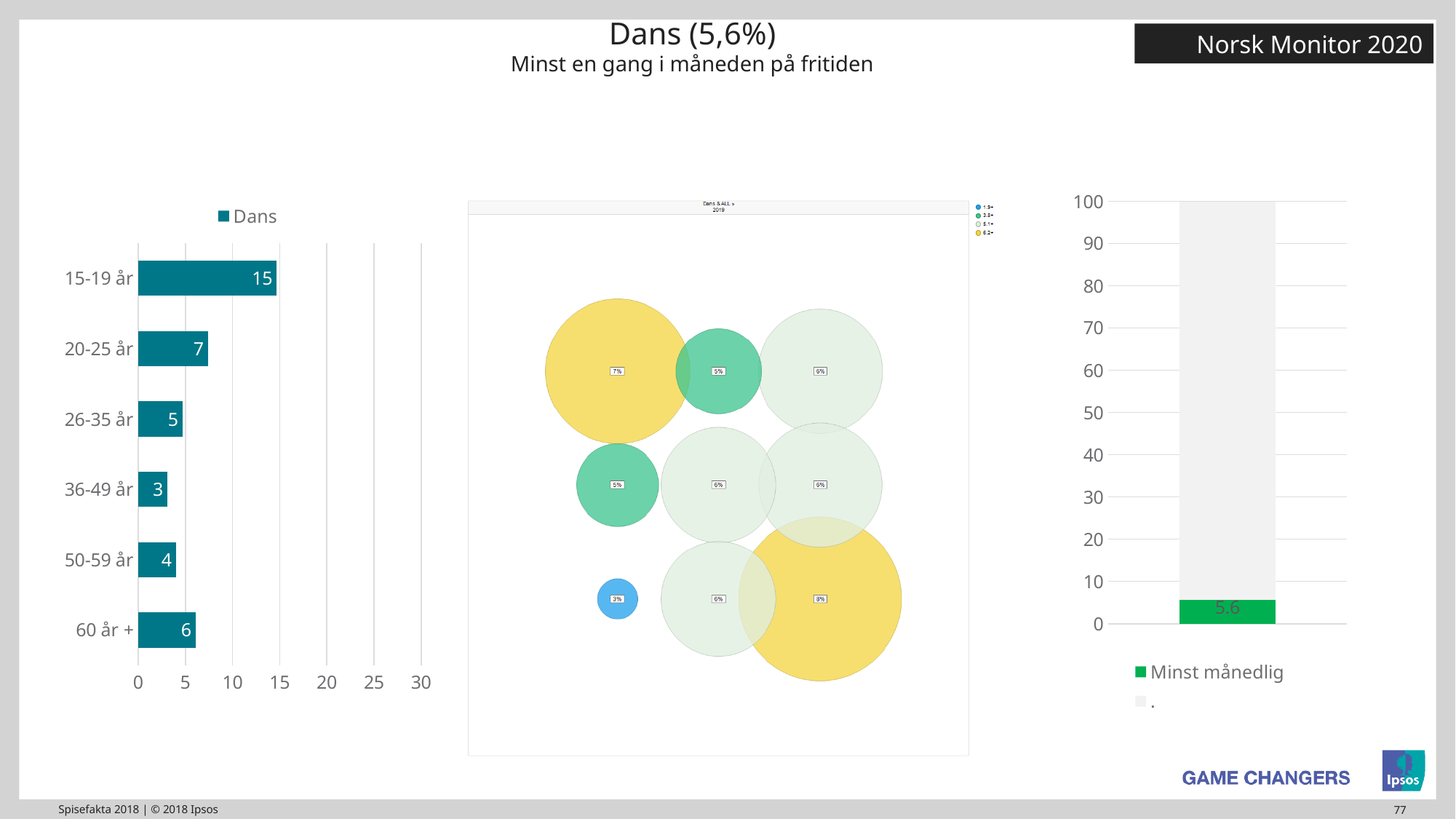
In the left bar chart, what is the difference between the values for 15-19 år and 20-25 år? 8 How many age groups are shown in the left bar chart? 6 In the left bar chart, what series name does the legend show? Dans In the left bar chart, which age group has the lowest value? 36-49 år In the left bar chart, which is larger: the value for 60 år + or the value for 50-59 år? 60 år + In the left bar chart, what is the value for 36-49 år? 3 What kind of chart is the left chart on the slide? Bar chart In the right chart, is the value for Minst månedlig greater or less than 10? less In the right chart, what is the value for Minst månedlig? 5.6 In the left bar chart, which age group has the highest value? 15-19 år In the left bar chart, what is the value for 15-19 år? 15 How many entries does the legend of the right chart list? 2